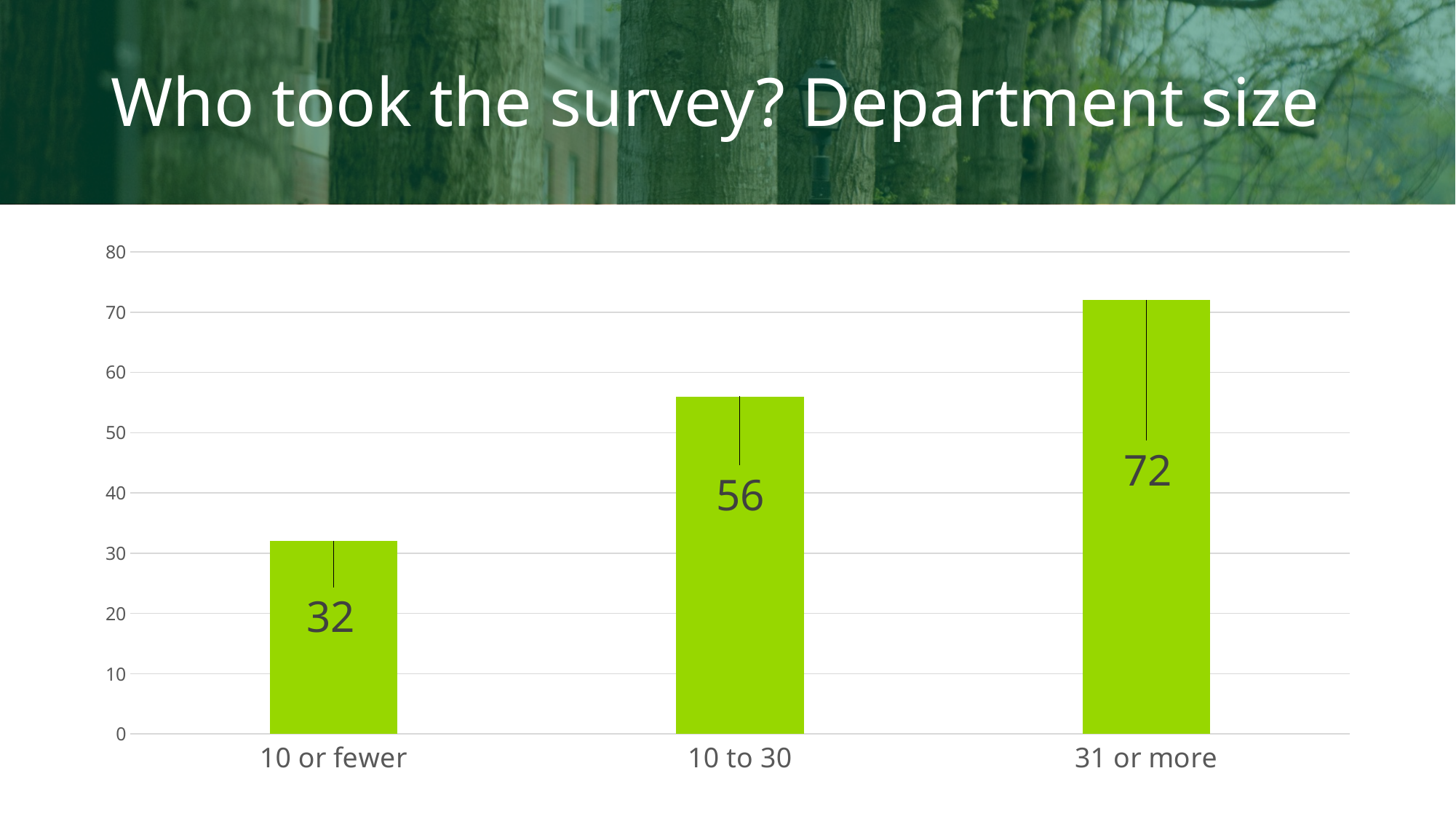
What is the difference between the values for '31 or more' and '10 or fewer'? 40 What kind of chart is shown on the slide? bar chart Which department size category has the lowest value? 10 or fewer What is the value for the '31 or more' category? 72 Do the values rise or fall from left to right along the x axis? rise Is the value for '10 to 30' greater or less than 50? greater What is the value for the '10 to 30' category? 56 What is the difference between the values for '10 to 30' and '10 or fewer'? 24 Which is larger, the value for '10 to 30' or the value for '31 or more'? 31 or more Which department size category has the highest value? 31 or more How many categories are shown on the x axis? 3 What is the value for the '10 or fewer' category? 32